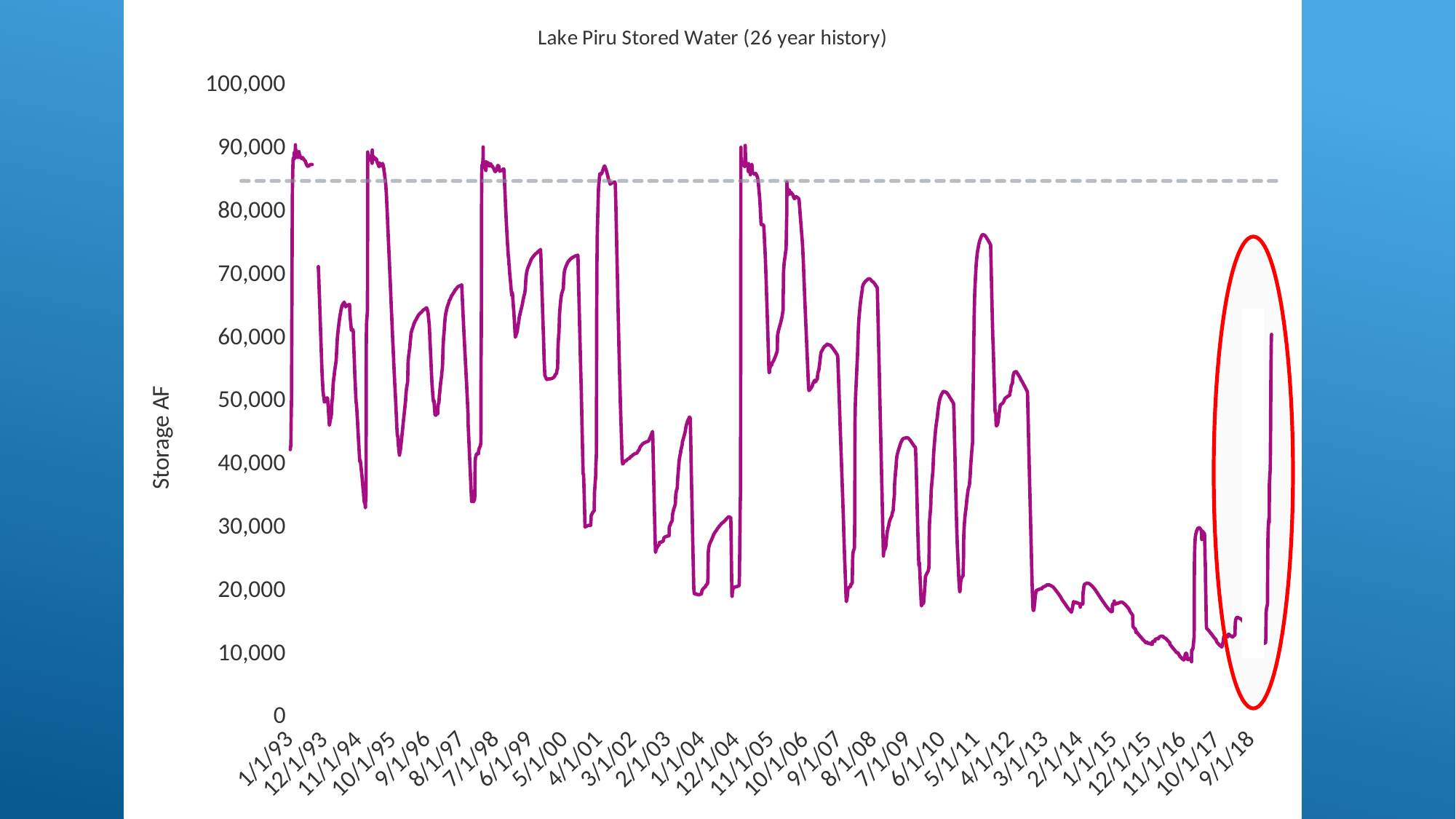
Is the stored water value around 11/1/16 greater or less than 20,000? less What is the label on the vertical axis of the chart? Storage AF What is the title of the chart? Lake Piru Stored Water (26 year history) Is the stored water value around 1/1/04 greater or less than 30,000? less Overall, do the stored water values rise or fall from 1993 to 2018? fall What is the last date label on the horizontal axis? 9/1/18 What is the highest value shown on the vertical axis? 100,000 Is the final spike in stored water near 9/1/18 greater or less than 50,000? greater What is the first date label on the horizontal axis? 1/1/93 What kind of chart is shown on the slide? line chart